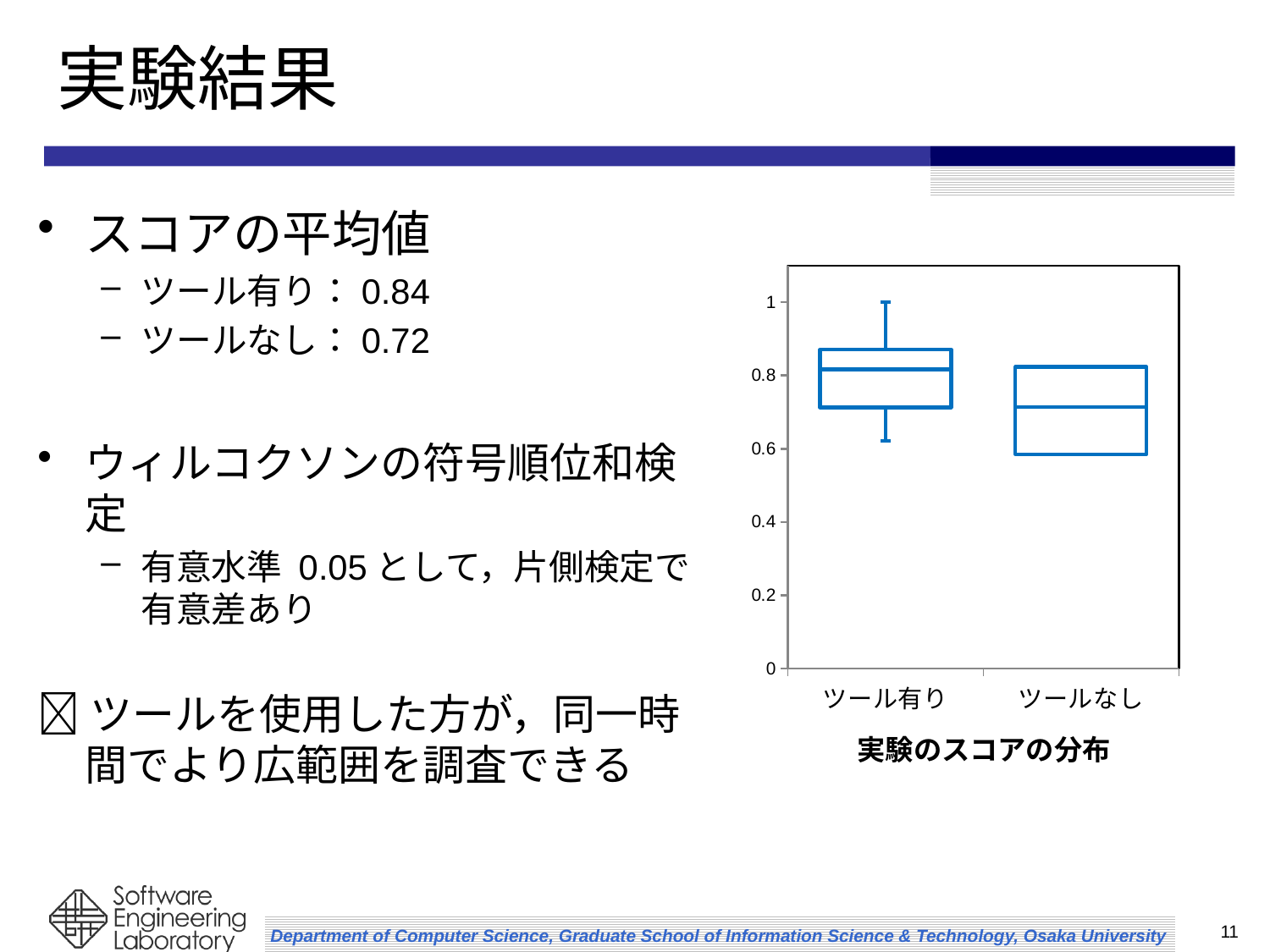
What is the highest tick value shown on the y axis of the chart? 1 Which category's box extends lower on the y axis, ツール有り or ツールなし? ツールなし What is the title printed below the chart? 実験のスコアの分布 Is the bottom edge of the box for ツールなし greater or less than 0.4? greater What kind of chart is shown on the slide? box plot Is the top edge of the box for ツール有り greater or less than 0.8? greater Is the median line for ツールなし greater or less than 0.6? greater What are the two category labels on the x axis of the chart? ツール有り, ツールなし Which category has the higher median line in the chart, ツール有り or ツールなし? ツール有り How many categories are shown on the x axis of the chart? 2